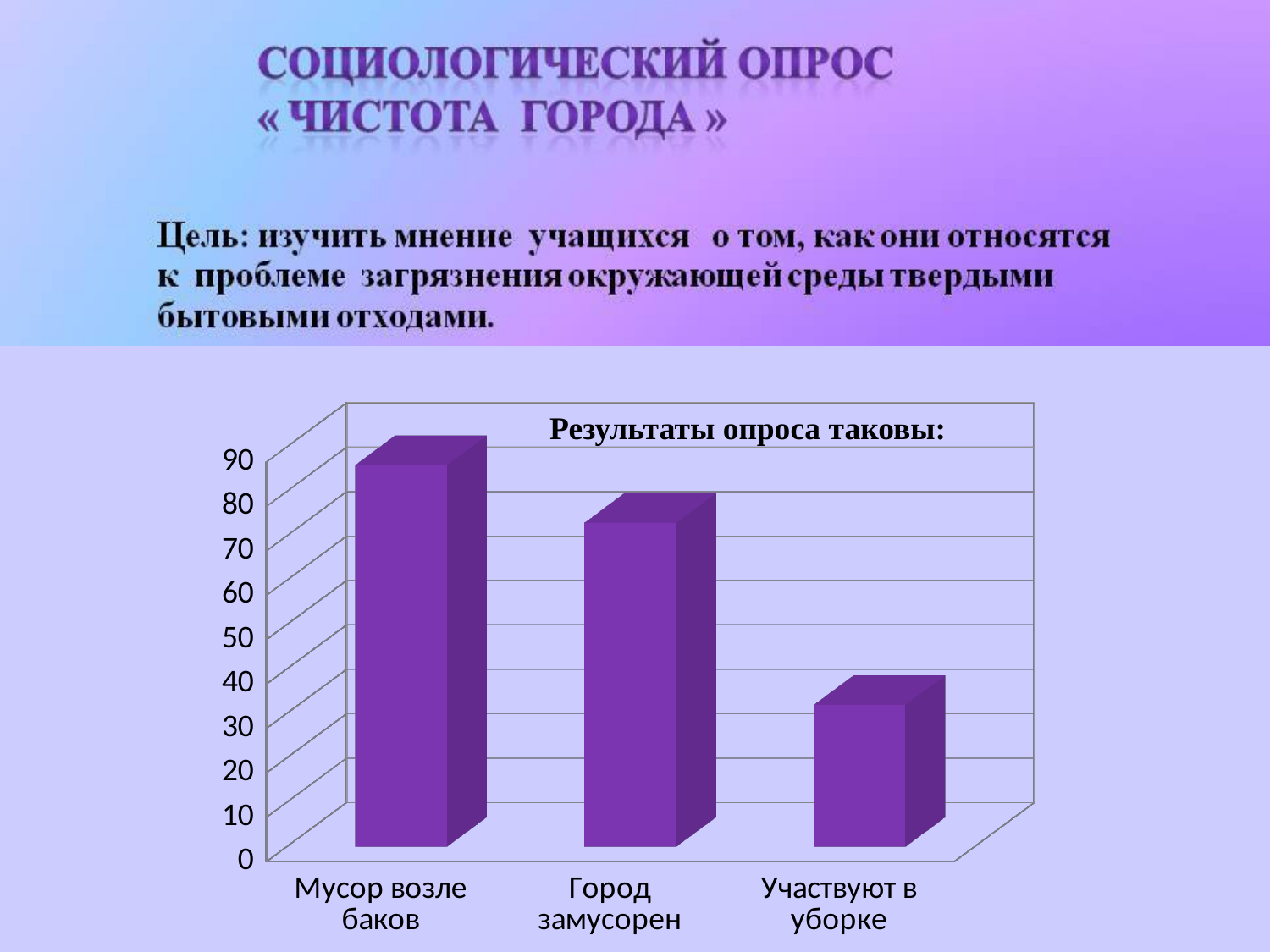
Is the value for Город замусорен greater or less than 80? less Is the value for Участвуют в уборке greater or less than 40? less What is the title of the chart? Результаты опроса таковы: Which category has the lowest bar? Участвуют в уборке How many categories are shown in the chart? 3 What kind of chart is shown on the slide? bar chart Is the value for Мусор возле баков greater or less than 80? greater Which category has the highest bar? Мусор возле баков Which is larger, the value for Мусор возле баков or the value for Город замусорен? Мусор возле баков Do the bar values rise or fall from left to right across the categories? fall Which is larger, the value for Город замусорен or the value for Участвуют в уборке? Город замусорен